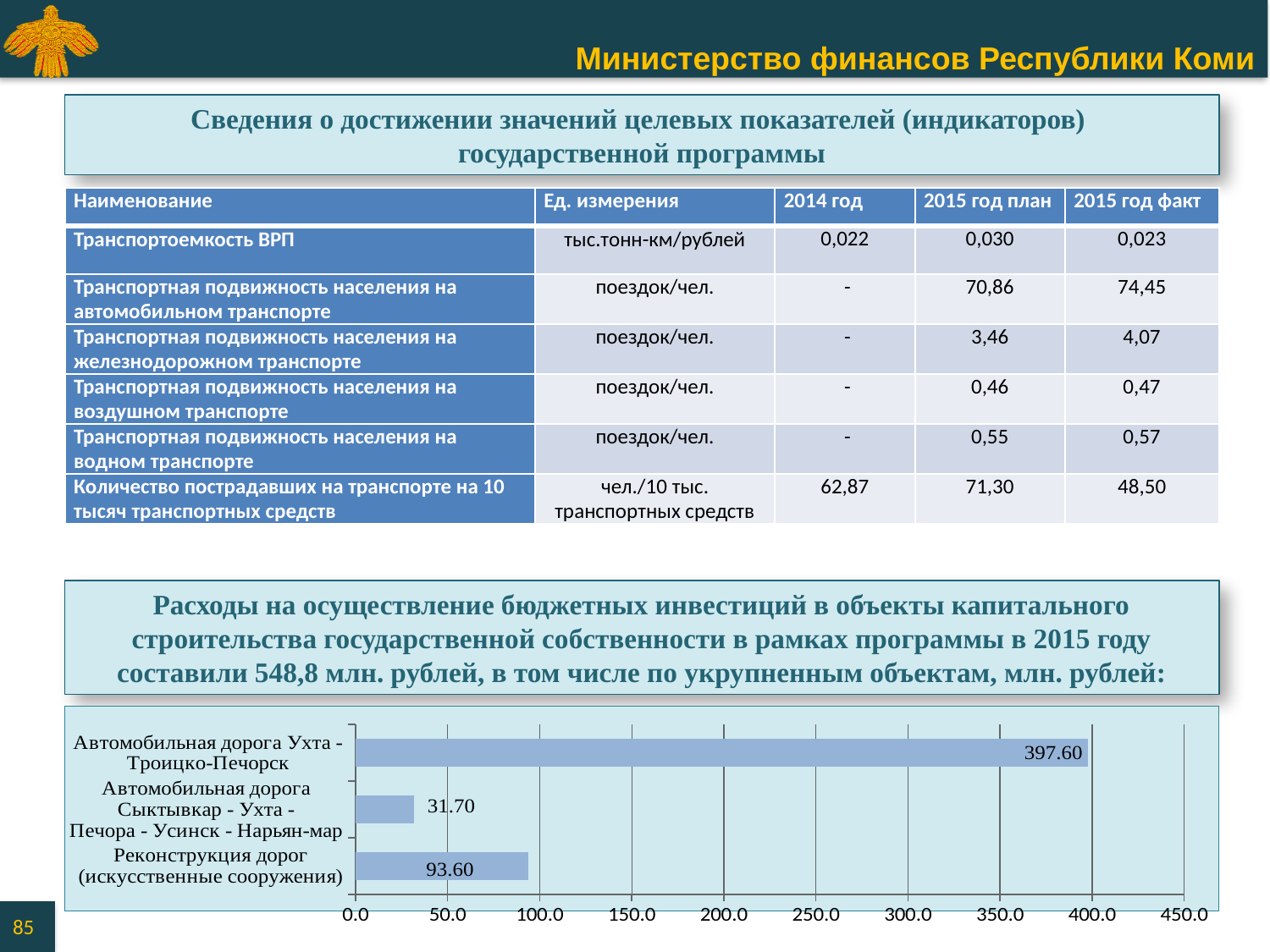
How many categories does the bar chart show? 3 In the bar chart, is the value for "Автомобильная дорога Ухта - Троицко-Печорск" greater or less than 350.0? greater What is the difference between the values for "Реконструкция дорог (искусственные сооружения)" and "Автомобильная дорога Сыктывкар - Ухта - Печора - Усинск - Нарьян-мар" in the bar chart? 61.90 What is the value for "Автомобильная дорога Сыктывкар - Ухта - Печора - Усинск - Нарьян-мар" in the bar chart? 31.70 What is the difference between the values for "Автомобильная дорога Ухта - Троицко-Печорск" and "Реконструкция дорог (искусственные сооружения)" in the bar chart? 304.00 What is the value for "Автомобильная дорога Ухта - Троицко-Печорск" in the bar chart? 397.60 What is the value for "Реконструкция дорог (искусственные сооружения)" in the bar chart? 93.60 What is the maximum value shown on the horizontal axis of the bar chart? 450.0 Which category has the lowest value in the bar chart? Автомобильная дорога Сыктывкар - Ухта - Печора - Усинск - Нарьян-мар In the bar chart, which is larger: the value for "Реконструкция дорог (искусственные сооружения)" or the value for "Автомобильная дорога Сыктывкар - Ухта - Печора - Усинск - Нарьян-мар"? Реконструкция дорог (искусственные сооружения) What kind of chart is shown at the bottom of the slide? bar chart Which category has the highest value in the bar chart? Автомобильная дорога Ухта - Троицко-Печорск